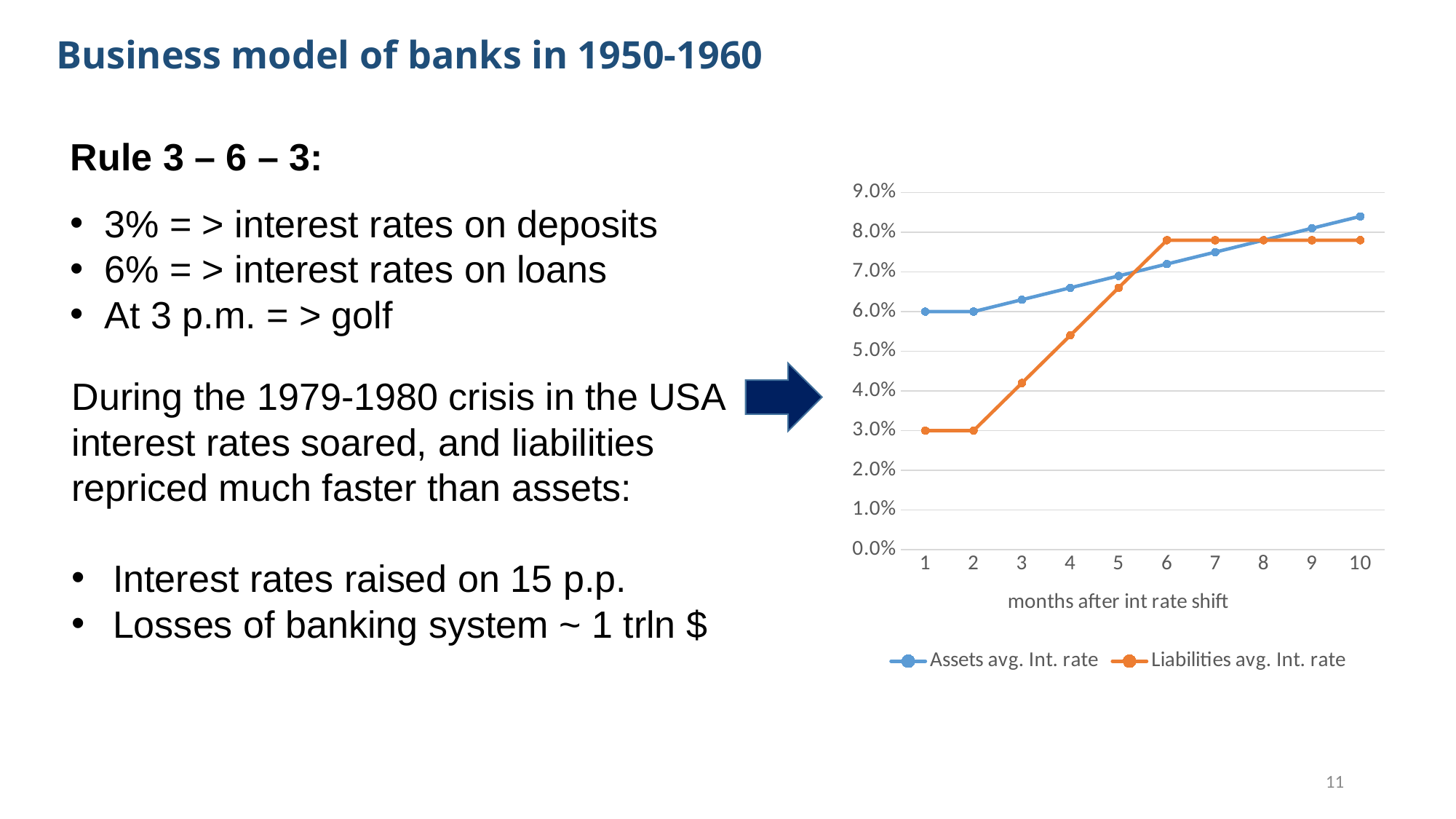
How many months are plotted along the x axis of the chart? 10 Is the Liabilities avg. Int. rate at month 4 greater or less than 5.0%? greater What kind of chart is shown on the slide? line chart Does the Assets avg. Int. rate rise or fall from month 2 to month 10? rise What is the label of the x axis of the chart? months after int rate shift At month 3, which series has the higher value, Assets avg. Int. rate or Liabilities avg. Int. rate? Assets avg. Int. rate What is the Assets avg. Int. rate at month 1? 6.0% Is the Liabilities avg. Int. rate at month 3 greater or less than 5.0%? less What is the Liabilities avg. Int. rate at month 2? 3.0% What is the Liabilities avg. Int. rate at month 1? 3.0% How many series does the chart legend list? 2 Is the Assets avg. Int. rate at month 10 greater or less than 8.0%? greater